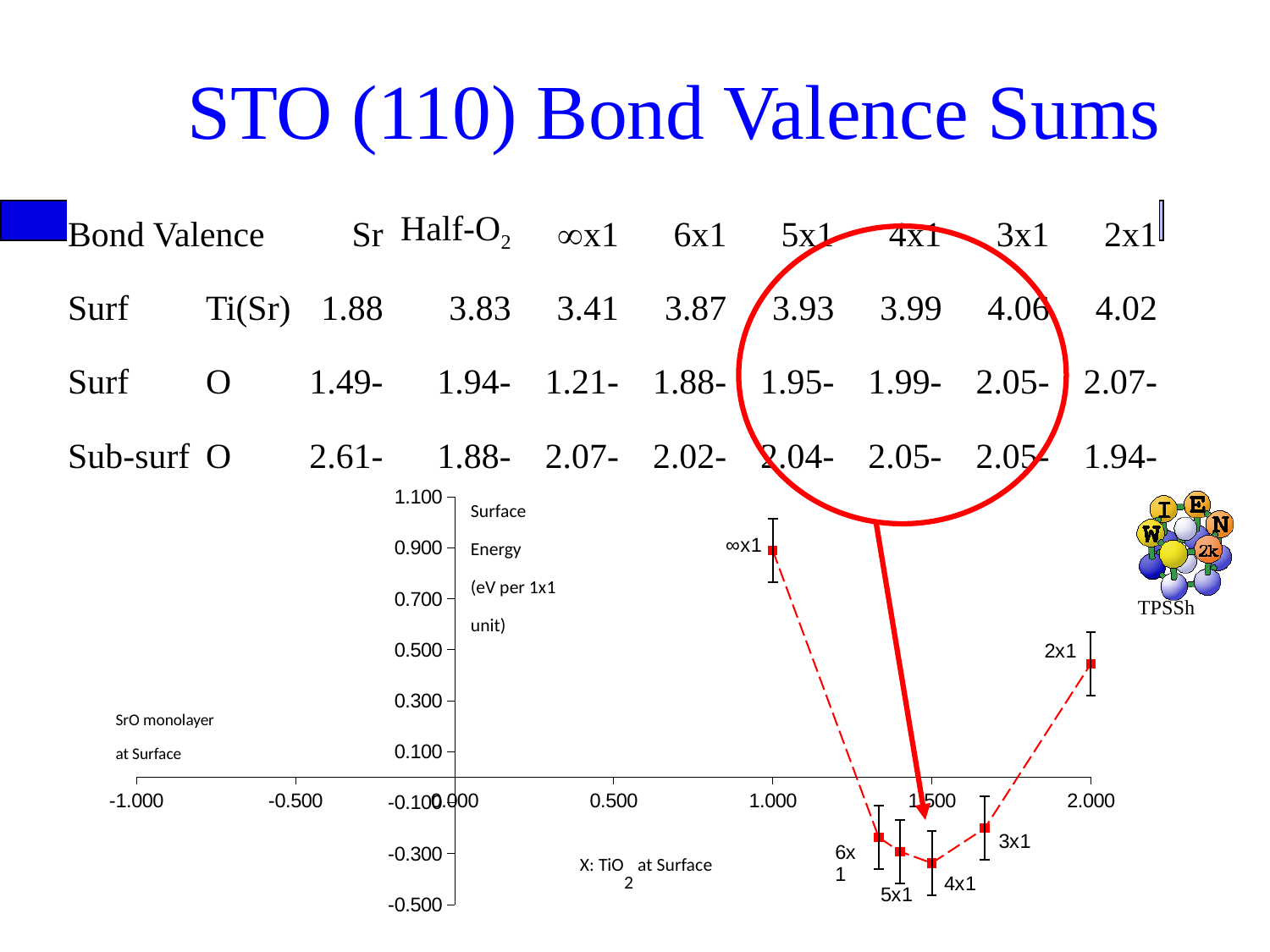
Which has the higher surface energy, ∞x1 or 2x1? ∞x1 What is the label on the x axis of the chart? X: TiO2 at Surface How many data points are plotted in the surface energy chart? 6 Is the surface energy for 2x1 greater or less than 0.300? greater Is the surface energy for 4x1 greater or less than -0.100? less What kind of chart is shown at the bottom of the slide? scatter chart Which labelled point has the highest surface energy? ∞x1 Is the surface energy for ∞x1 greater or less than 0.700? greater Which labelled point has the lowest surface energy? 4x1 Does the surface energy rise or fall going from ∞x1 to 4x1 along the x axis? fall At what x-axis value is the 4x1 point plotted? 1.500 Which has the higher surface energy, 3x1 or 2x1? 2x1